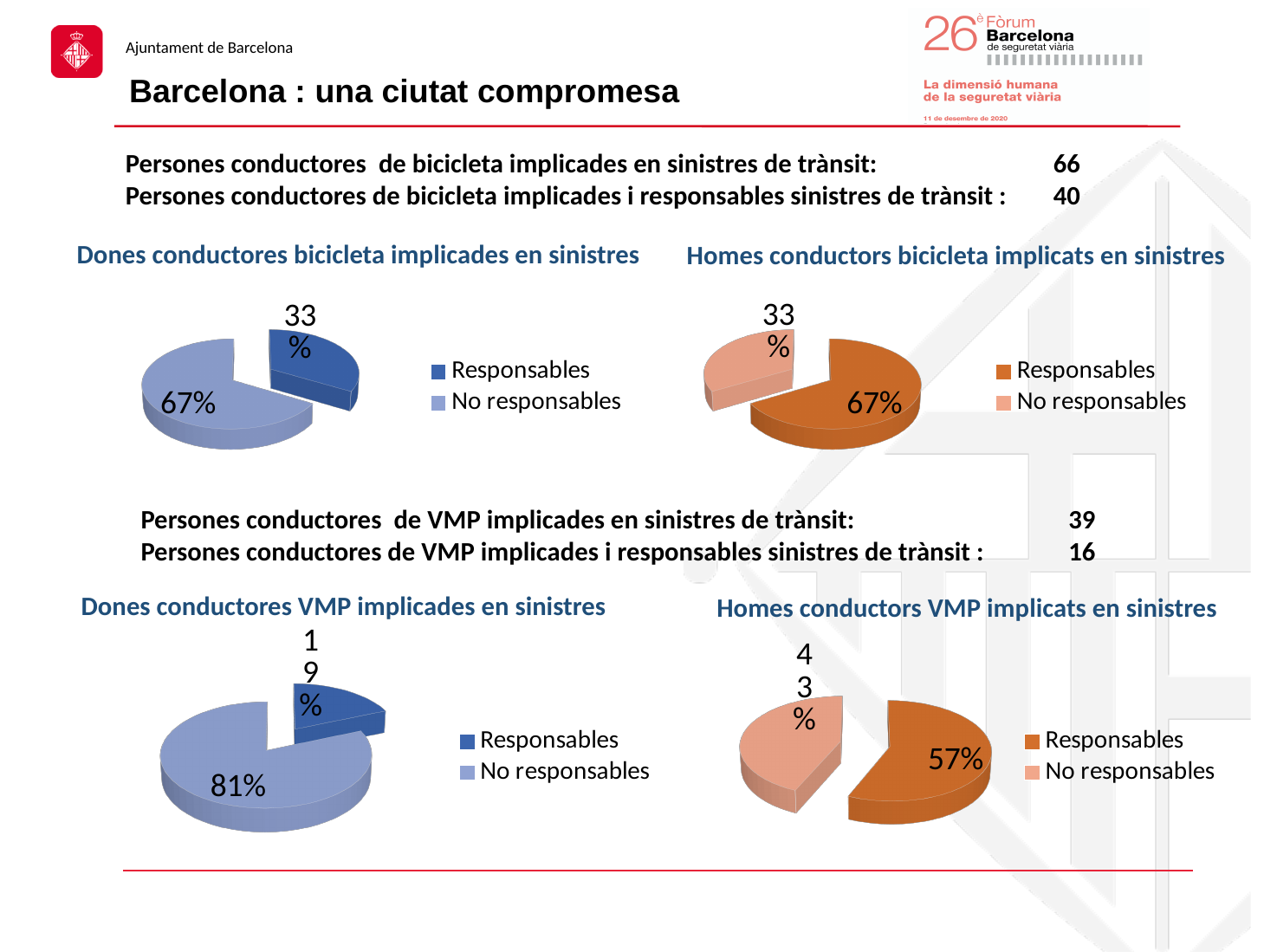
In the chart titled "Homes conductors bicicleta implicats en sinistres", what share of the pie is "Responsables"? 67% In the chart titled "Dones conductores bicicleta implicades en sinistres", what share of the pie is "No responsables"? 67% In the chart titled "Homes conductors VMP implicats en sinistres", what is the difference between the "Responsables" and "No responsables" shares? 14% In the chart titled "Dones conductores VMP implicades en sinistres", what share of the pie is "Responsables"? 19% What kind of chart is used for "Homes conductors VMP implicats en sinistres"? Pie chart How many series does the legend of the chart titled "Dones conductores VMP implicades en sinistres" list? 2 In the chart titled "Homes conductors bicicleta implicats en sinistres", which slice is the largest? Responsables In the chart titled "Dones conductores bicicleta implicades en sinistres", which slice is the smallest? Responsables How many pie charts are shown on the slide? 4